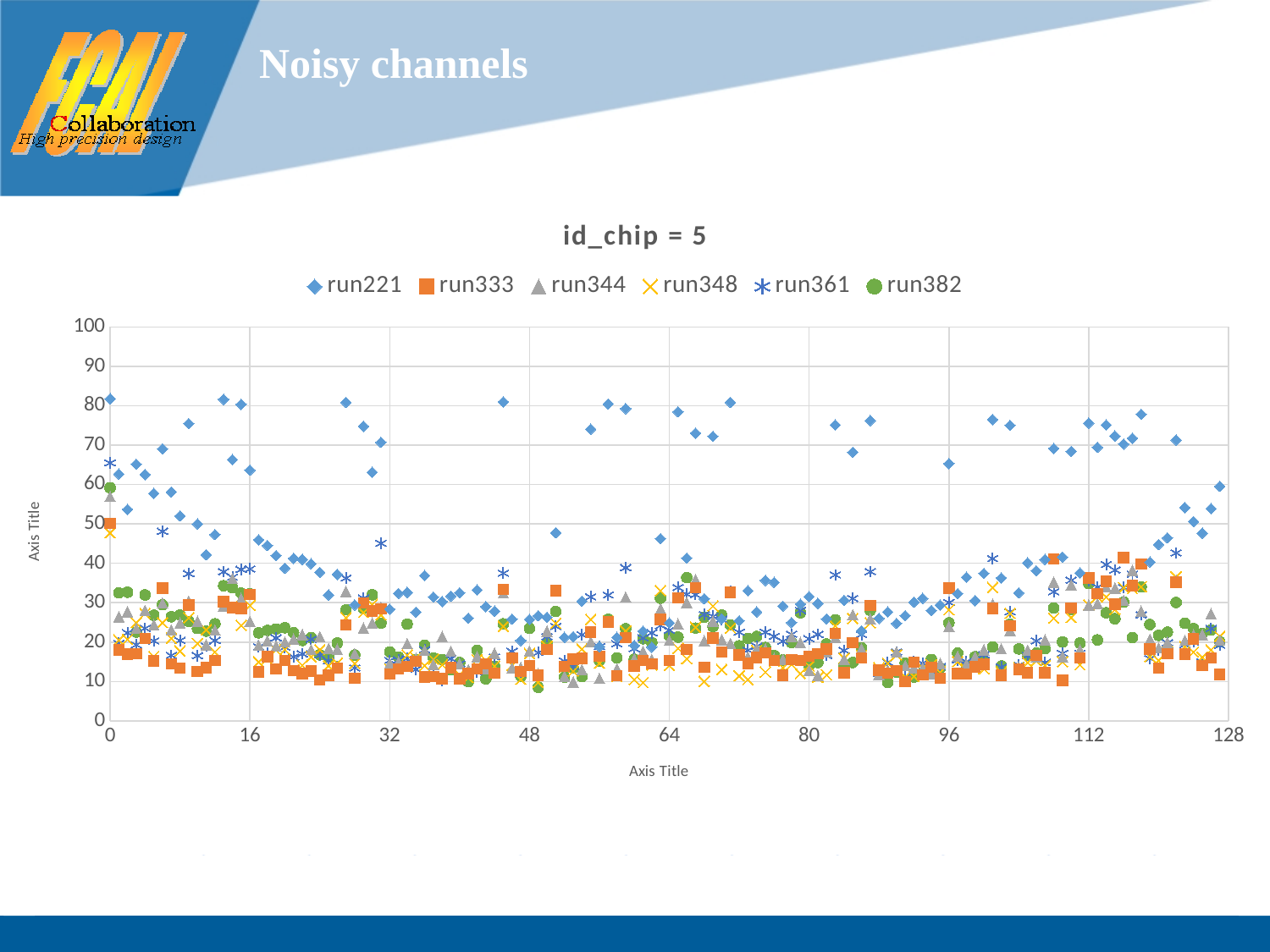
Is the value for run221 at x = 0 greater or less than 70? greater Is the value for run333 at x = 0 greater or less than 40? greater What is the maximum value shown on the y axis? 100 How many series does the legend list? 6 What kind of chart is shown on the slide? Scatter chart Which series is plotted with green circle markers? run382 What is the title of the chart? id_chip = 5 Do any plotted points exceed 90 on the y axis? No Which series generally has the highest values across the x axis? run221 What is the maximum value shown on the x axis? 128